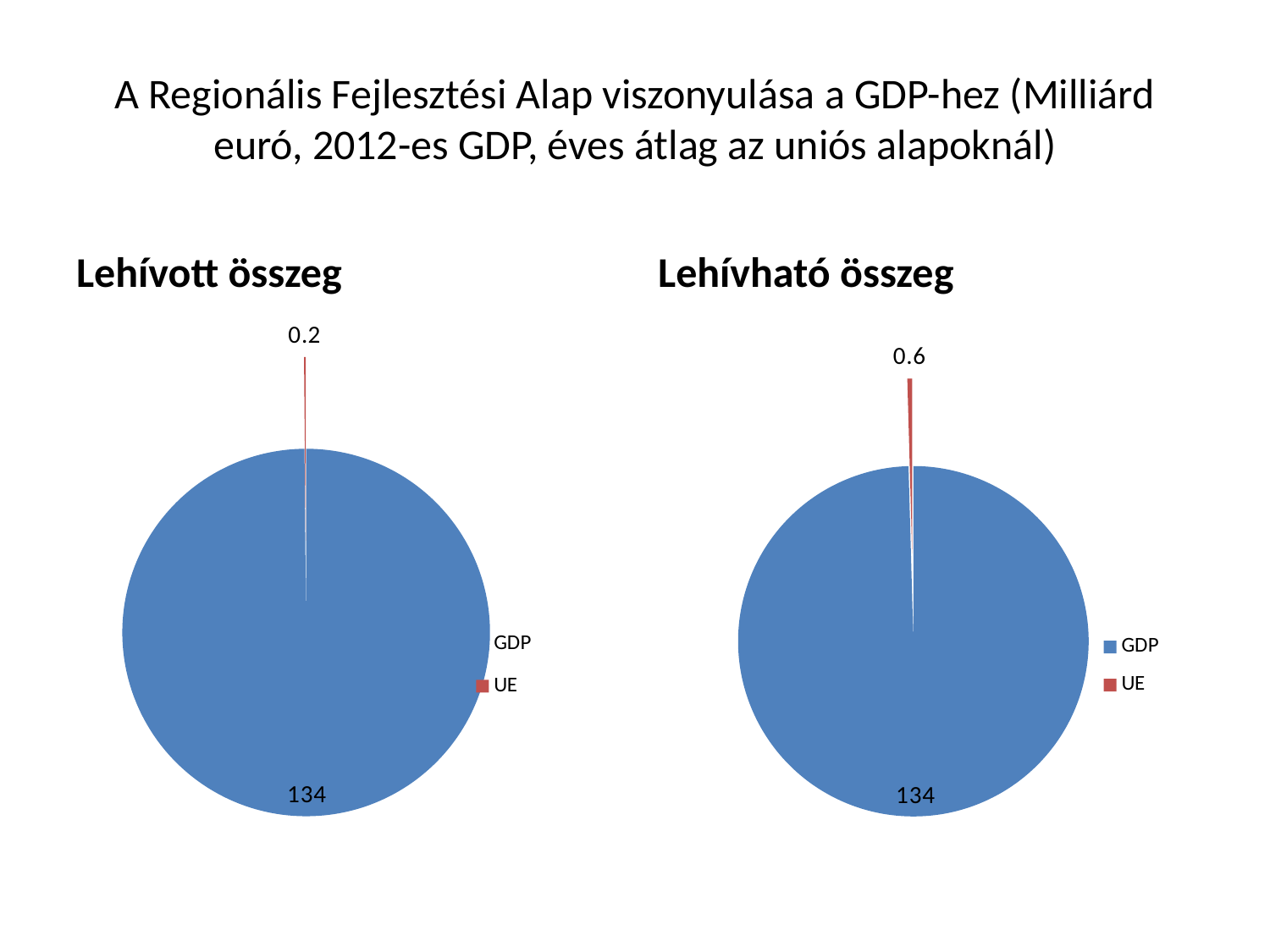
Is the UE value larger in the "Lehívott összeg" chart or in the "Lehívható összeg" chart? Lehívható összeg In the "Lehívható összeg" chart, what colour is the GDP slice? blue In the "Lehívott összeg" chart, what is the value for UE? 0.2 In the "Lehívható összeg" chart, which category has the smallest slice? UE What kind of chart is the "Lehívott összeg" chart? pie chart In the "Lehívható összeg" chart, what is the value for GDP? 134 In the "Lehívott összeg" chart, what is the difference between the GDP value and the UE value? 133.8 How many categories does the "Lehívható összeg" chart show? 2 In the "Lehívott összeg" chart, which category has the largest slice? GDP In the "Lehívható összeg" chart, what is the difference between the GDP value and the UE value? 133.4 In the "Lehívott összeg" chart, what is the value for GDP? 134 In the "Lehívható összeg" chart, what is the value for UE? 0.6